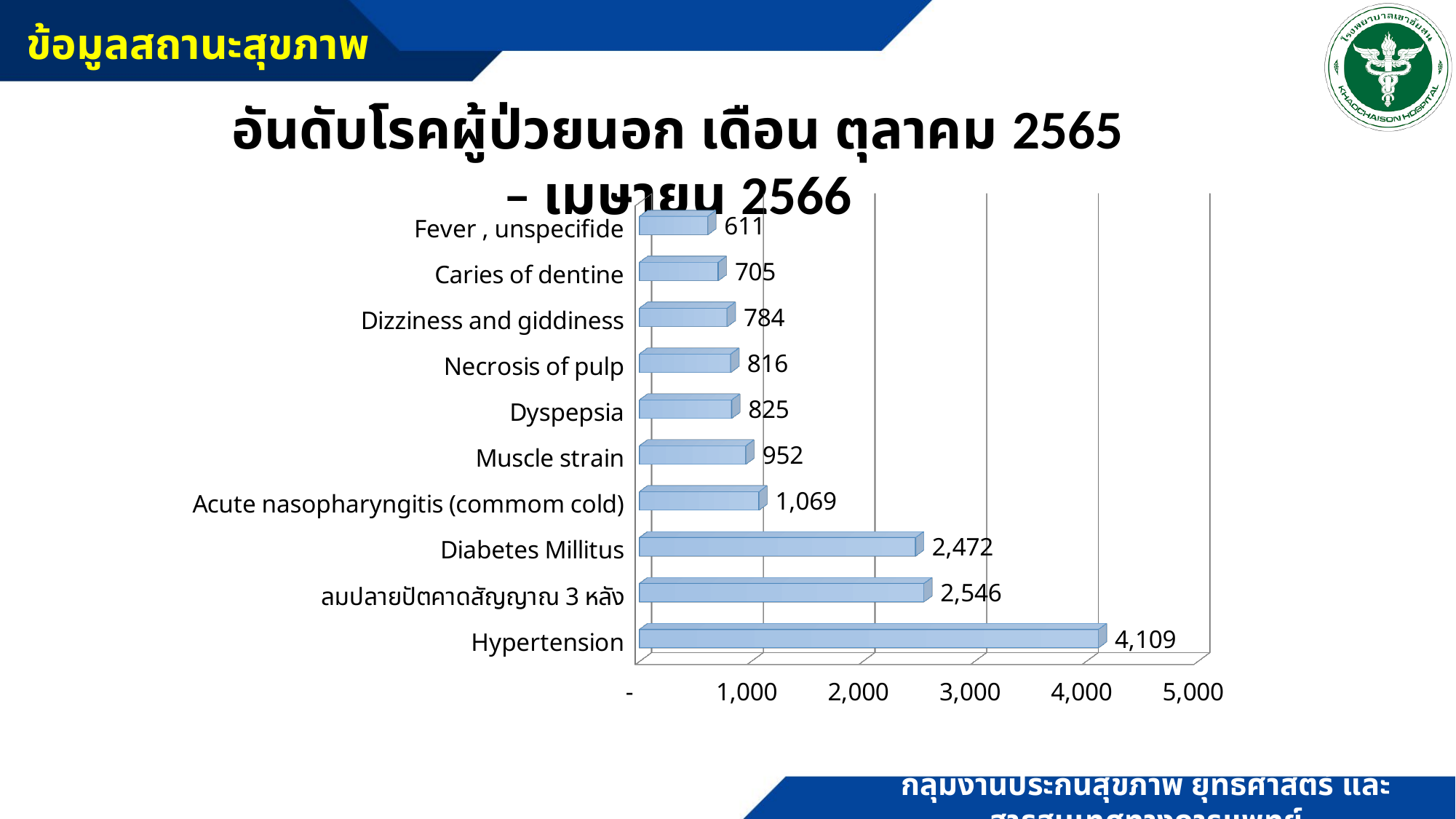
What is the difference between the values for Muscle strain and Dyspepsia? 127 What is the value for Acute nasopharyngitis (commom cold)? 1,069 Which category has the lowest value? Fever , unspecifide How many categories are shown in the chart? 10 What kind of chart is shown on the slide? bar chart Which category has the highest value? Hypertension What is the value for Hypertension? 4,109 What is the value for Diabetes Millitus? 2,472 Which is larger, the value for Necrosis of pulp or the value for Caries of dentine? Necrosis of pulp What is the difference between the values for Hypertension and Diabetes Millitus? 1,637 What is the value for Dizziness and giddiness? 784 What is the value for Fever , unspecifide? 611